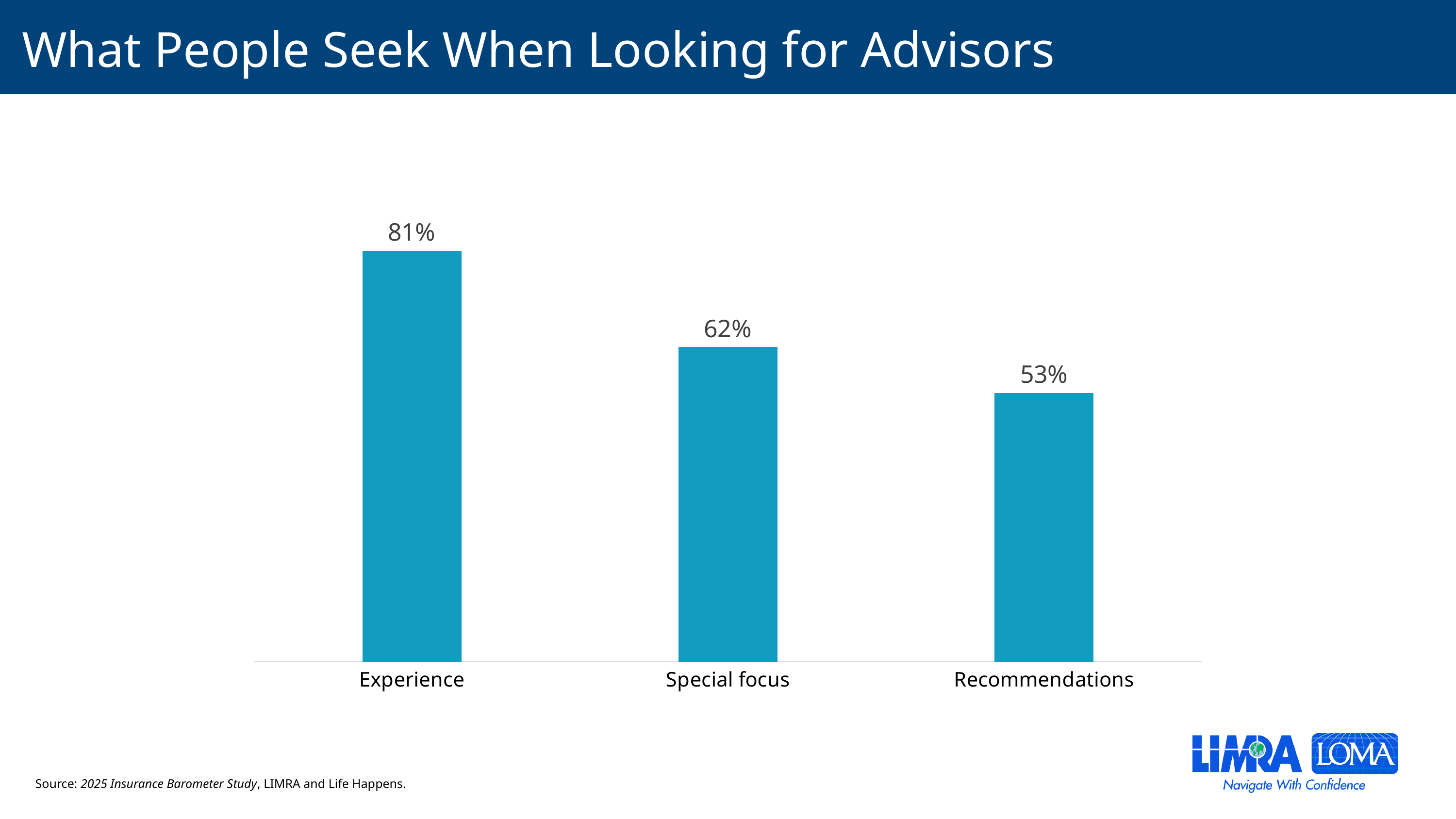
What is the title of the slide? What People Seek When Looking for Advisors Which category has the highest value? Experience Which category has the lowest value? Recommendations What is the difference between the values for Experience and Special focus? 19% What is the difference between the values for Special focus and Recommendations? 9% How many categories are shown in the chart? 3 What kind of chart is shown on the slide? Bar chart What is the value shown for Special focus? 62% Do the values rise or fall from left to right across the categories? Fall What is the value shown for Recommendations? 53% What percentage of people seek Experience when looking for advisors? 81% Which is larger, the value for Special focus or the value for Recommendations? Special focus